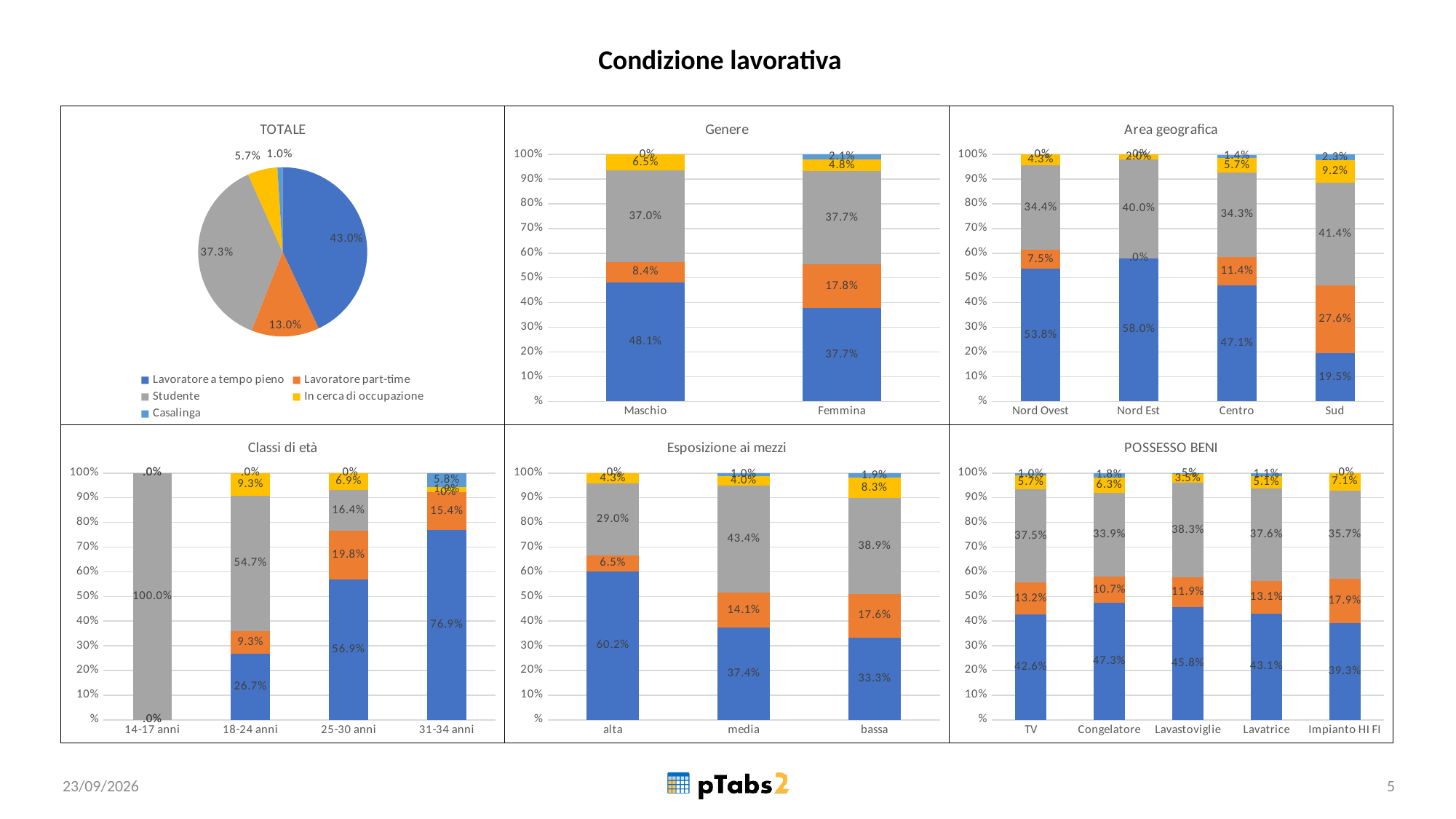
In the Esposizione ai mezzi chart, is the Lavoratore a tempo pieno value larger for alta or for bassa? alta In the Genere chart, what is the Lavoratore part-time value for Femmina? 17.8% In the Area geografica chart, what is the Studente value for Nord Est? 40.0% In the Genere chart, what is the difference between the Lavoratore a tempo pieno values for Maschio and Femmina? 10.4% In the POSSESSO BENI chart, what is the Lavoratore part-time value for Impianto HI FI? 17.9% How many series does the legend of the TOTALE chart list? 5 What kind of chart is the TOTALE chart? Pie chart In the Area geografica chart, which area has the lowest Lavoratore a tempo pieno value? Sud In the TOTALE pie chart, what share is Lavoratore a tempo pieno? 43.0% In the TOTALE pie chart, which category has the smallest slice? Casalinga How many age categories are shown in the Classi di età chart? 4 In the Classi di età chart, what is the Lavoratore a tempo pieno value for 31-34 anni? 76.9%